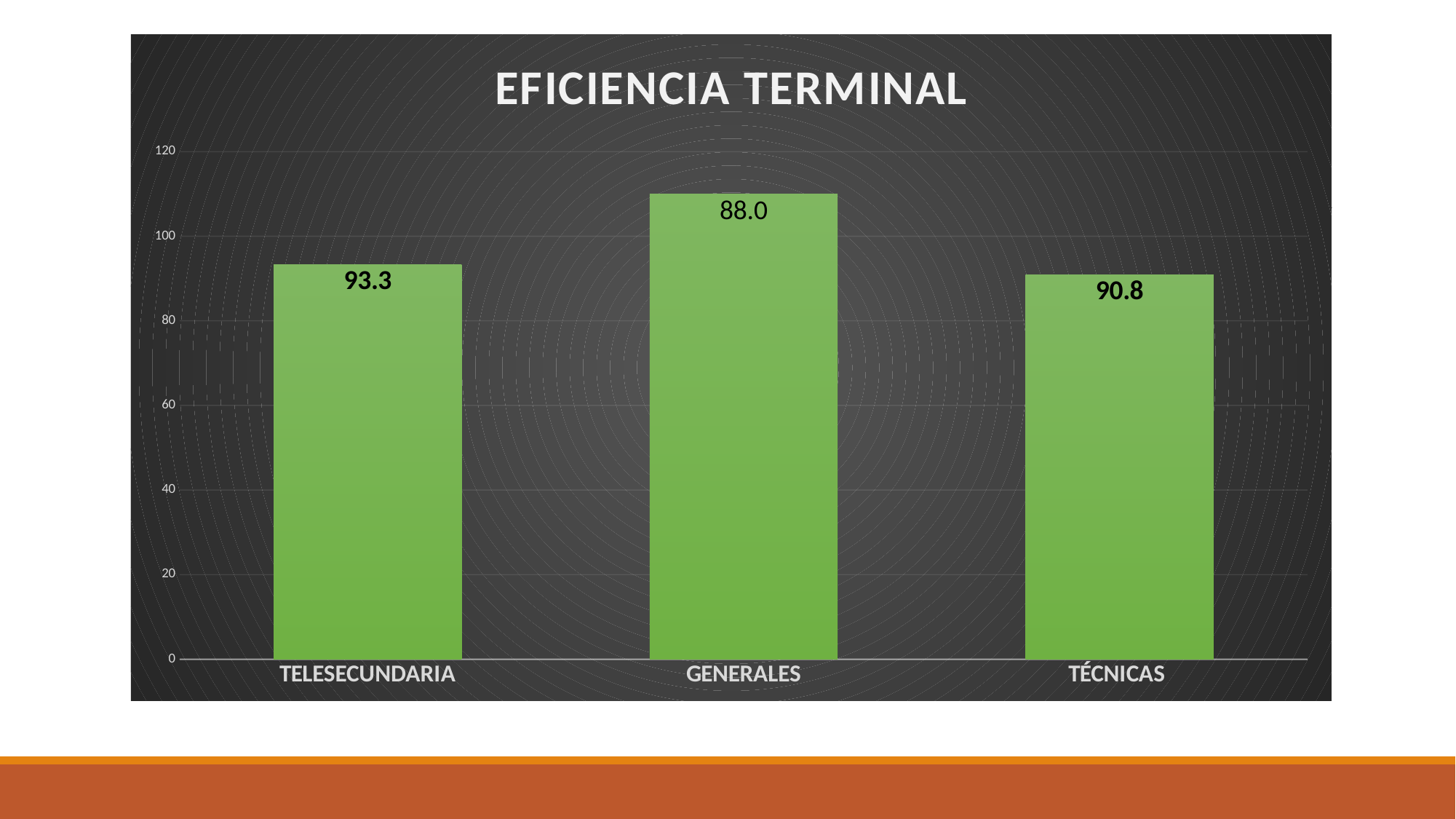
What is the value for GENERALES? 88.0 What is the value for TELESECUNDARIA? 93.3 Is the value for TELESECUNDARIA greater or less than 80? greater Is the value for TÉCNICAS greater or less than 60? greater What colour are the bars in the chart? green What is the difference between the values for TELESECUNDARIA and TÉCNICAS? 2.5 What is the value for TÉCNICAS? 90.8 How many categories are shown on the chart? 3 Which is larger, the value for TELESECUNDARIA or the value for TÉCNICAS? TELESECUNDARIA What is the title of the chart? EFICIENCIA TERMINAL What kind of chart is shown on the slide? bar chart